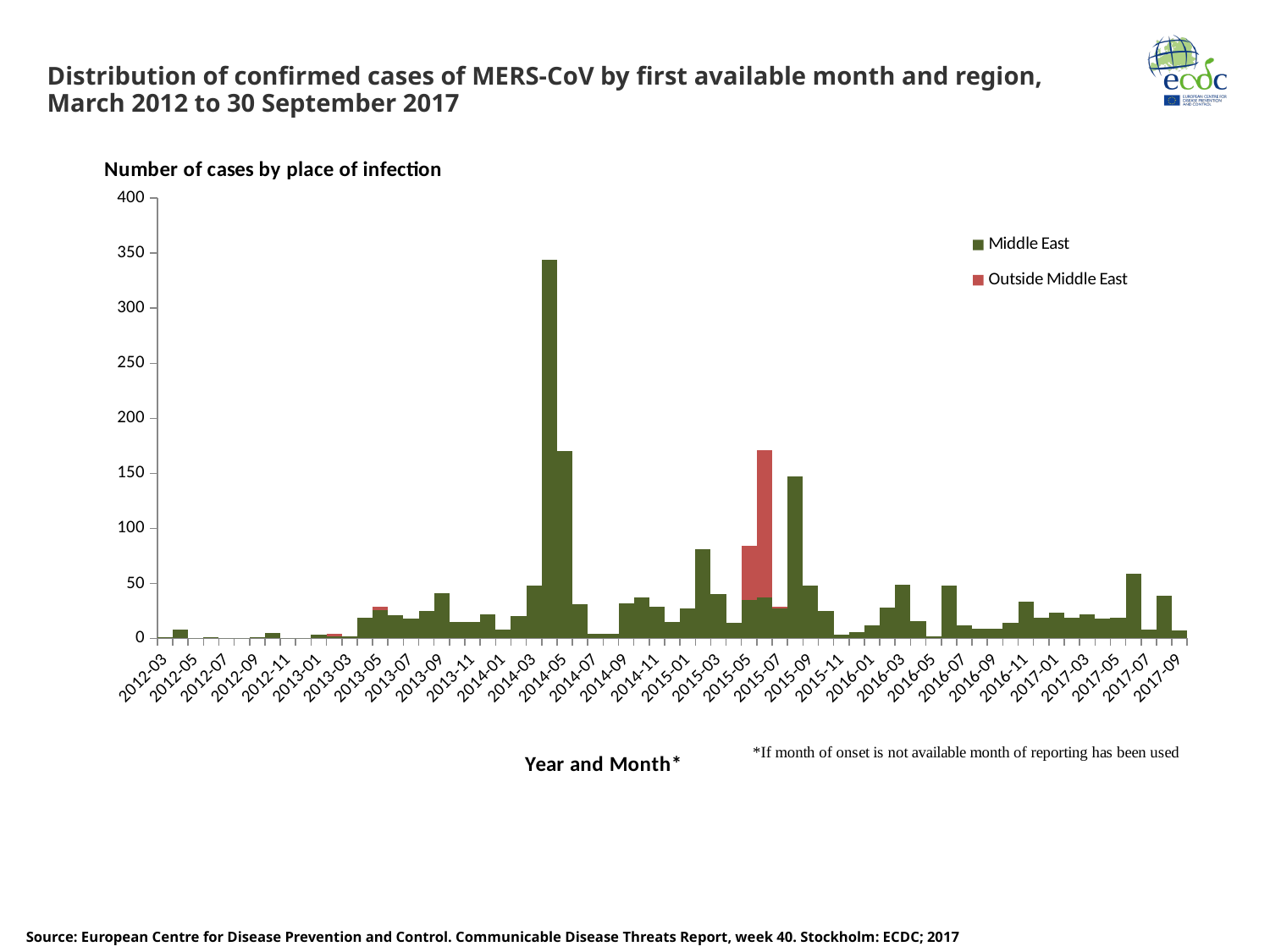
How many series does the legend list? 2 Which has more cases, 2014-05 or 2015-09? 2014-05 Which series accounts for the tallest bar in the chart? Middle East Is the value for 2016-05 greater or less than 50? less What is the title of the vertical axis? Number of cases by place of infection What are the two series named in the legend? Middle East and Outside Middle East Is the value for 2012-05 greater or less than 50? less Is the value for 2017-09 greater or less than 50? less Which has more cases, 2014-05 or 2017-09? 2014-05 What kind of chart is shown on the slide? bar chart